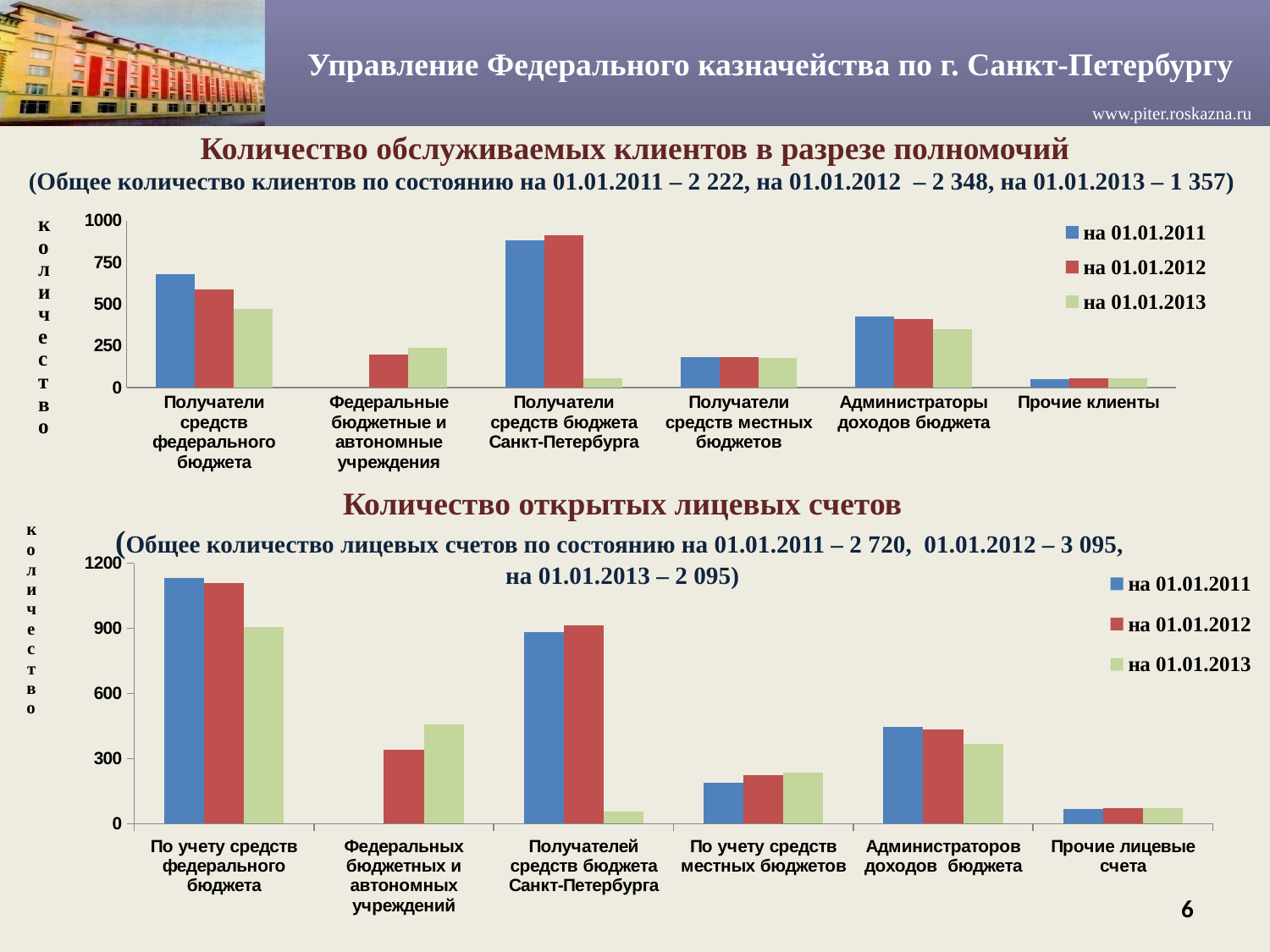
In the top chart, 'Количество обслуживаемых клиентов в разрезе полномочий', which is larger for 'на 01.01.2011': 'Администраторы доходов бюджета' or 'Получатели средств местных бюджетов'? Администраторы доходов бюджета What kind of chart is the top chart, 'Количество обслуживаемых клиентов в разрезе полномочий'? Bar chart How many categories are shown on the x axis of the top chart, 'Количество обслуживаемых клиентов в разрезе полномочий'? 6 How many series does the legend of the bottom chart, 'Количество открытых лицевых счетов', list? 3 In the bottom chart, 'Количество открытых лицевых счетов', which category has the highest value for 'на 01.01.2011'? По учету средств федерального бюджета In the top chart, 'Количество обслуживаемых клиентов в разрезе полномочий', which category has the highest value for 'на 01.01.2013'? Получатели средств федерального бюджета In the top chart, 'Количество обслуживаемых клиентов в разрезе полномочий', is the value for 'Получатели средств федерального бюджета' on 01.01.2011 greater or less than 500? greater In the top chart, 'Количество обслуживаемых клиентов в разрезе полномочий', is the value for 'Получатели средств бюджета Санкт-Петербурга' on 01.01.2013 greater or less than 250? less What are the three legend entries of the bottom chart, 'Количество открытых лицевых счетов'? на 01.01.2011, на 01.01.2012, на 01.01.2013 In the top chart, 'Количество обслуживаемых клиентов в разрезе полномочий', which category has the highest value for 'на 01.01.2011'? Получатели средств бюджета Санкт-Петербурга In the bottom chart, 'Количество открытых лицевых счетов', is the value for 'Федеральных бюджетных и автономных учреждений' on 01.01.2013 greater or less than 300? greater In the top chart, 'Количество обслуживаемых клиентов в разрезе полномочий', do the values for 'Получатели средств федерального бюджета' rise or fall from 01.01.2011 to 01.01.2013? fall